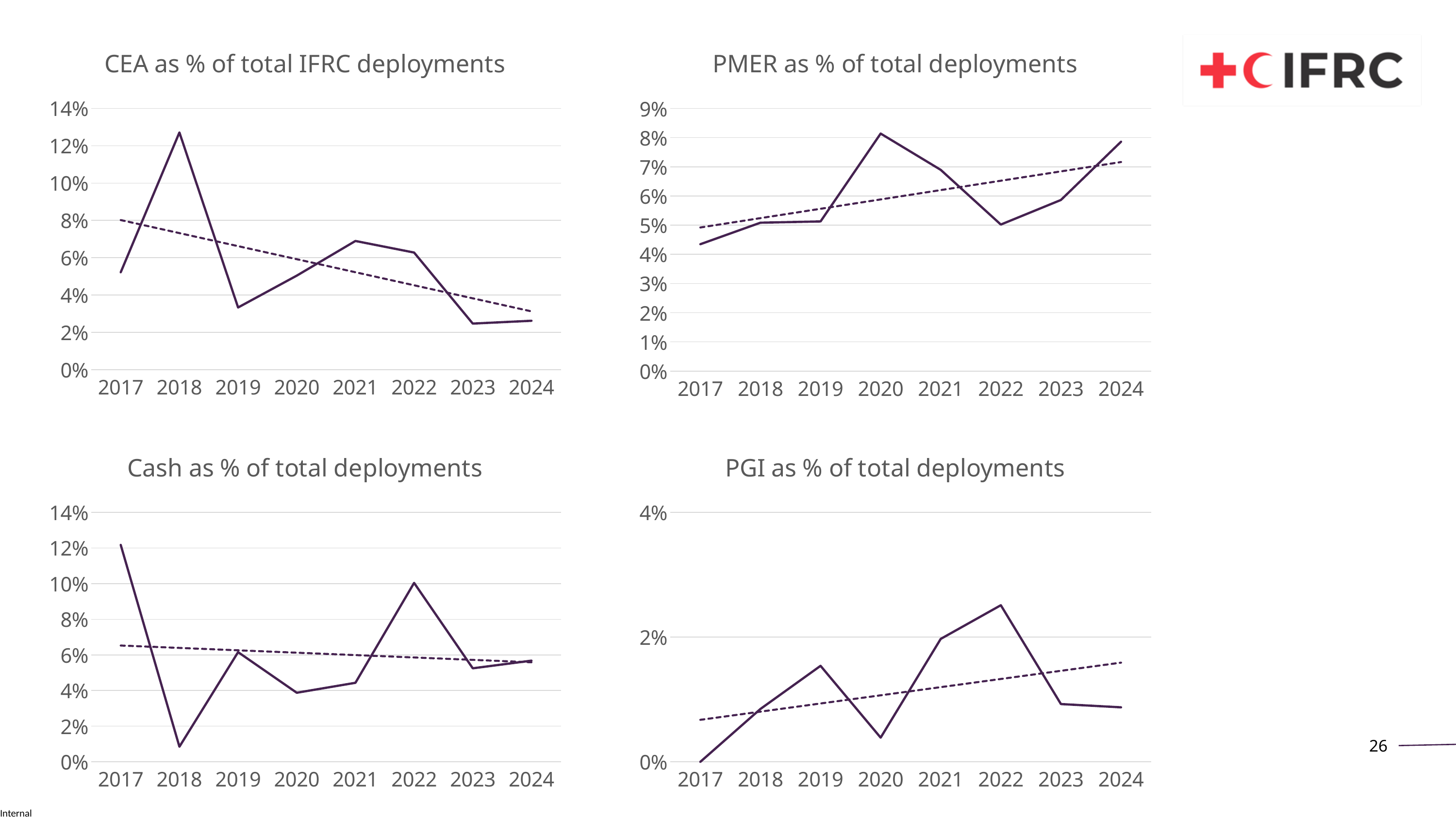
In the 'CEA as % of total IFRC deployments' chart, is the value for 2018 greater or less than 10%? greater In the 'PGI as % of total deployments' chart, which year has the highest value? 2022 In the 'Cash as % of total deployments' chart, which year has the lowest value? 2018 In the 'PMER as % of total deployments' chart, which year has the lowest value? 2017 In the 'CEA as % of total IFRC deployments' chart, does the dashed trend line rise or fall from 2017 to 2024? fall In the 'PMER as % of total deployments' chart, is the value for 2021 greater or less than 6%? greater In the 'Cash as % of total deployments' chart, which year has the highest value? 2017 How many years are plotted on the x axis of the 'Cash as % of total deployments' chart? 8 In the 'PGI as % of total deployments' chart, is the value for 2022 greater or less than 2%? greater In the 'CEA as % of total IFRC deployments' chart, which year has the highest value? 2018 In the 'PMER as % of total deployments' chart, does the dashed trend line rise or fall from 2017 to 2024? rise What kind of chart is 'CEA as % of total IFRC deployments'? line chart